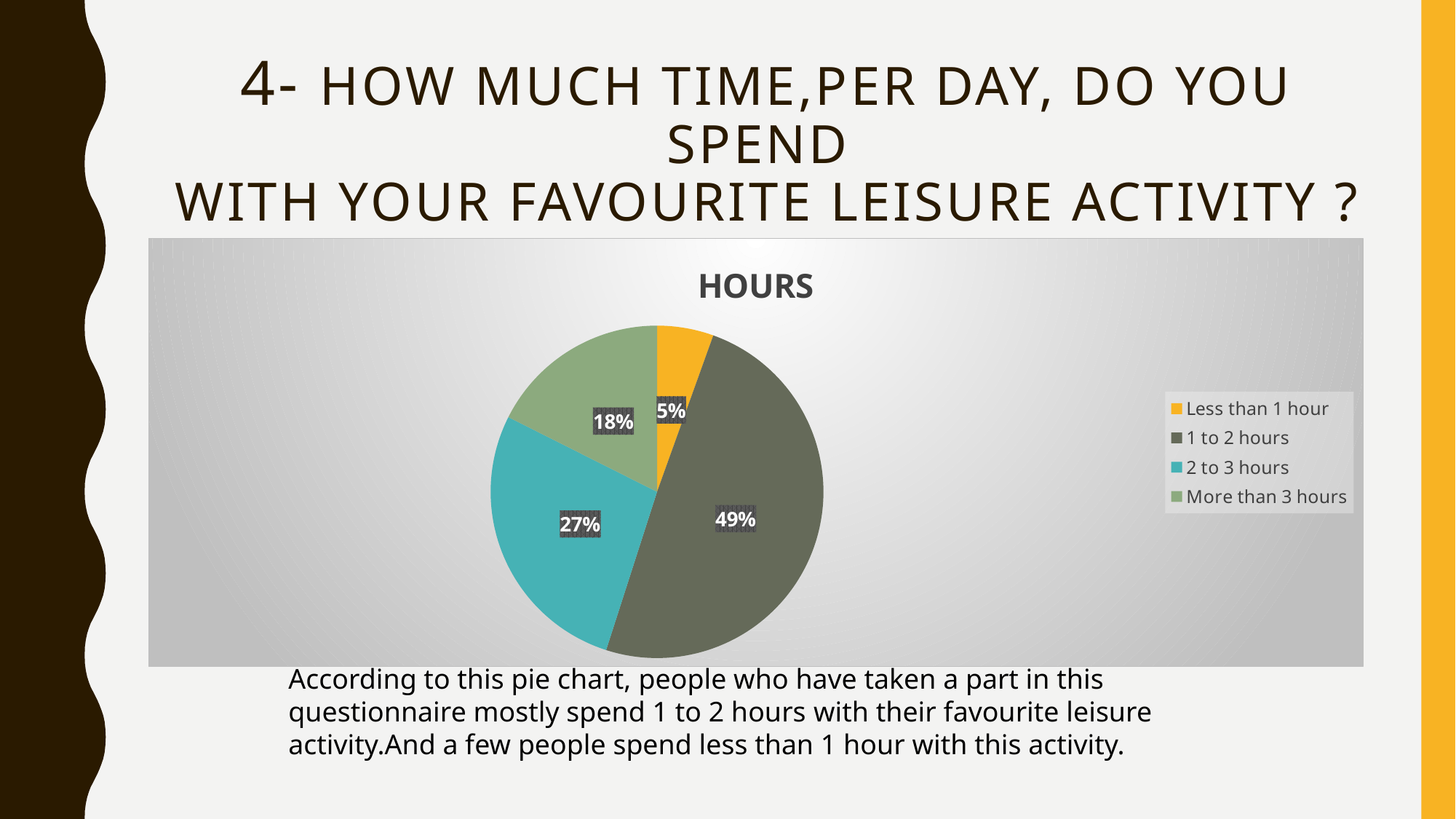
Which category has the largest share of the pie? 1 to 2 hours Which category has the smallest share of the pie? Less than 1 hour What percentage of respondents spend 1 to 2 hours on their favourite leisure activity? 49% Which colour represents the 'Less than 1 hour' category in the legend? yellow What is the title of the chart? HOURS What type of chart is shown on the slide? pie chart What percentage of respondents spend more than 3 hours on their favourite leisure activity? 18% Which is larger: the share for 2 to 3 hours or the share for More than 3 hours? 2 to 3 hours What percentage of respondents spend less than 1 hour on their favourite leisure activity? 5% How many categories does the pie chart have? 4 What is the difference in percentage points between the 1 to 2 hours slice and the 2 to 3 hours slice? 22 What percentage of respondents spend 2 to 3 hours on their favourite leisure activity? 27%